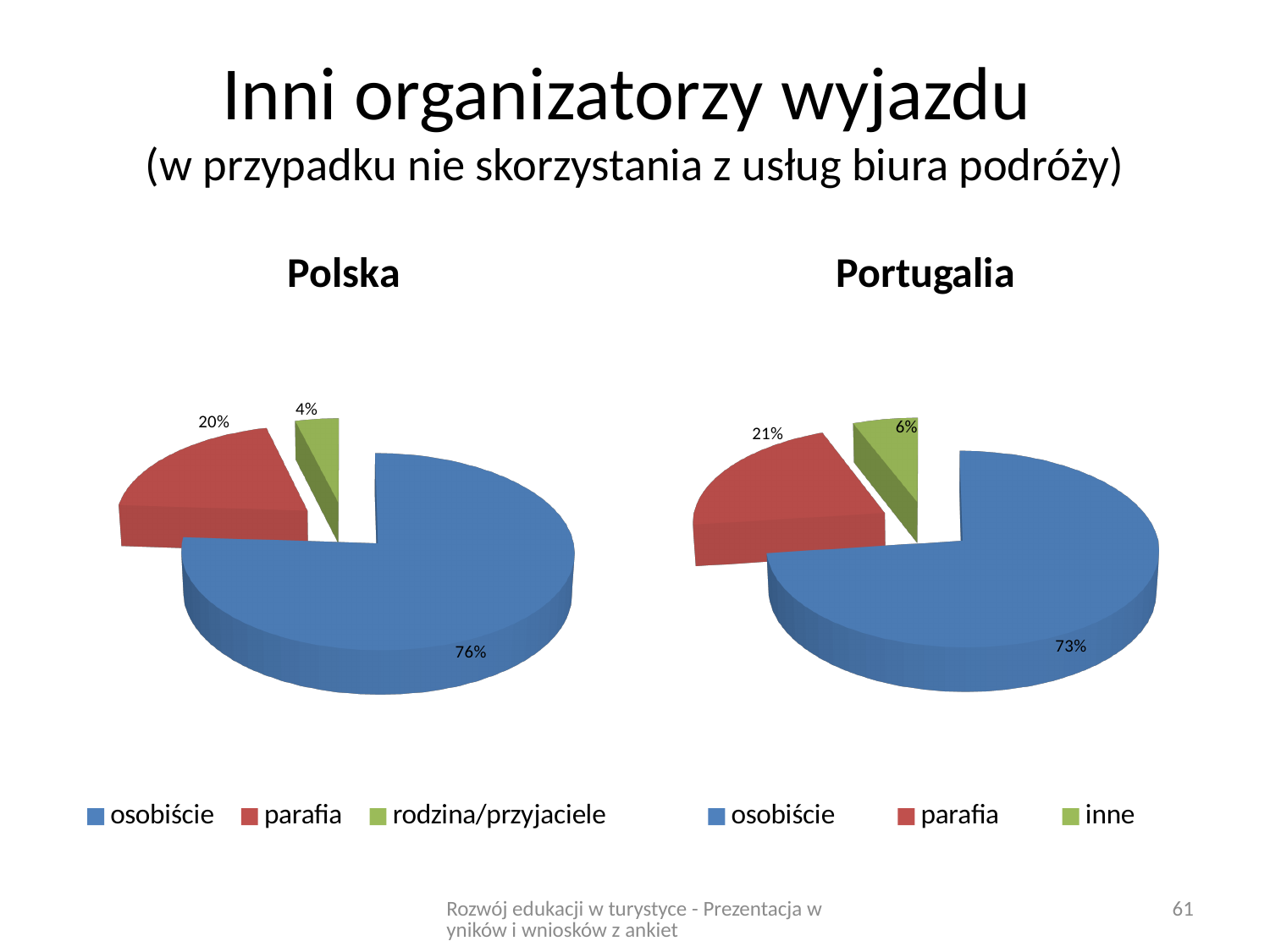
In the Portugalia chart, which category has the smallest slice? inne In the Polska chart, what is the difference between the osobiście and parafia shares? 56% In the Portugalia chart, what colour is the osobiście slice? blue How many entries does the legend of the Polska chart list? 3 What kind of chart is the Polska chart? pie chart In the Polska chart, what share does osobiście have? 76% In the Portugalia chart, what share does parafia have? 21% In the Polska chart, what share does rodzina/przyjaciele have? 4% How many slices does the Portugalia chart have? 3 Which is larger: the parafia share in the Polska chart or the parafia share in the Portugalia chart? Portugalia In the Polska chart, which category has the largest slice? osobiście In the Portugalia chart, what share does inne have? 6%